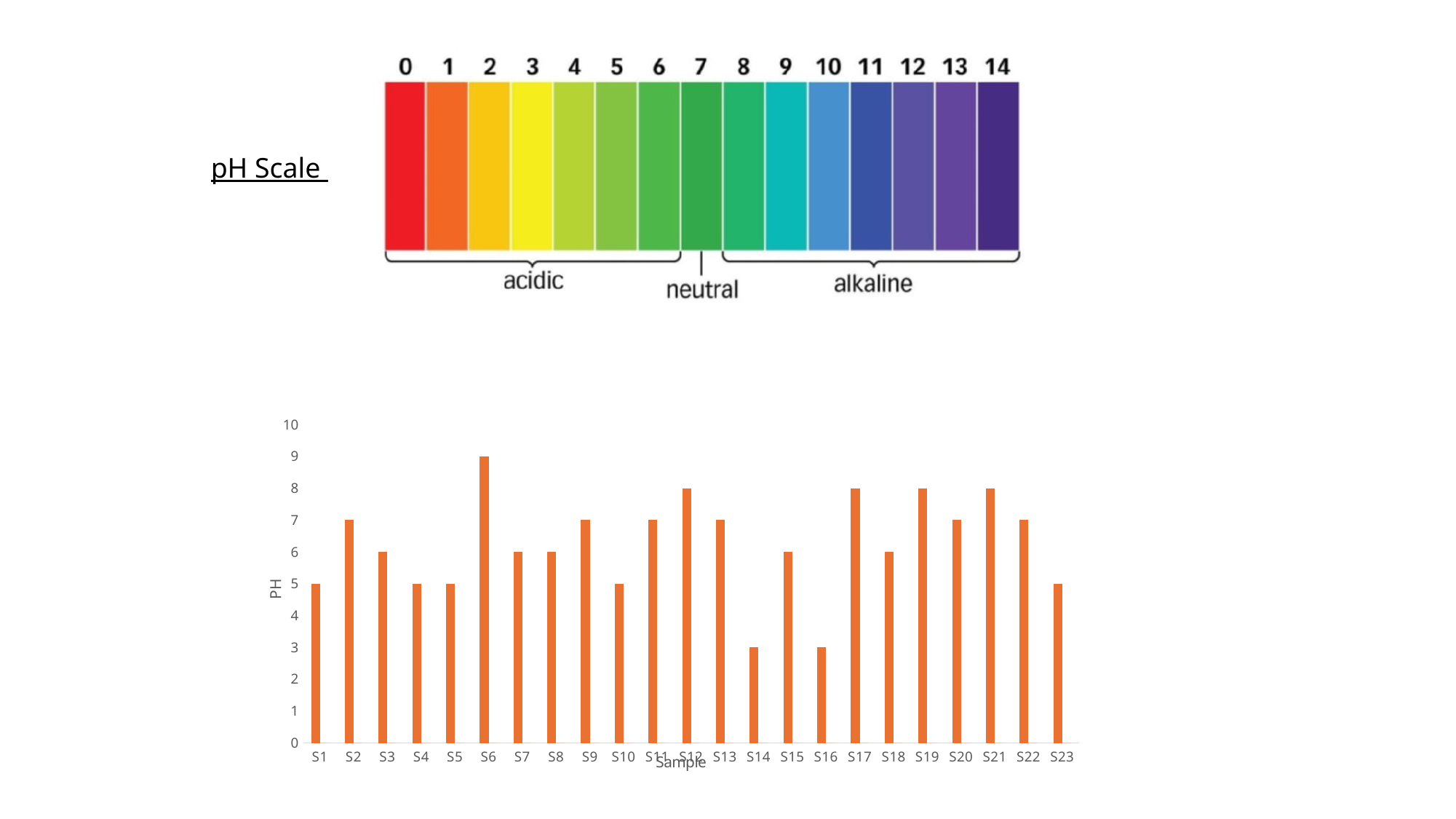
What kind of chart is shown on the slide? bar chart Is the pH value for S17 greater or less than 5? greater What is the difference between the pH values of S6 and S16? 6 What is the label of the vertical axis of the bar chart? PH How many samples are plotted on the x axis of the bar chart? 23 What is the pH value for sample S1? 5 Which sample has the highest pH value? S6 What is the pH value for sample S6? 9 Which has a higher pH value, S2 or S3? S2 What is the pH value for sample S12? 8 What is the lowest pH value shown in the bar chart? 3 What is the pH value for sample S14? 3